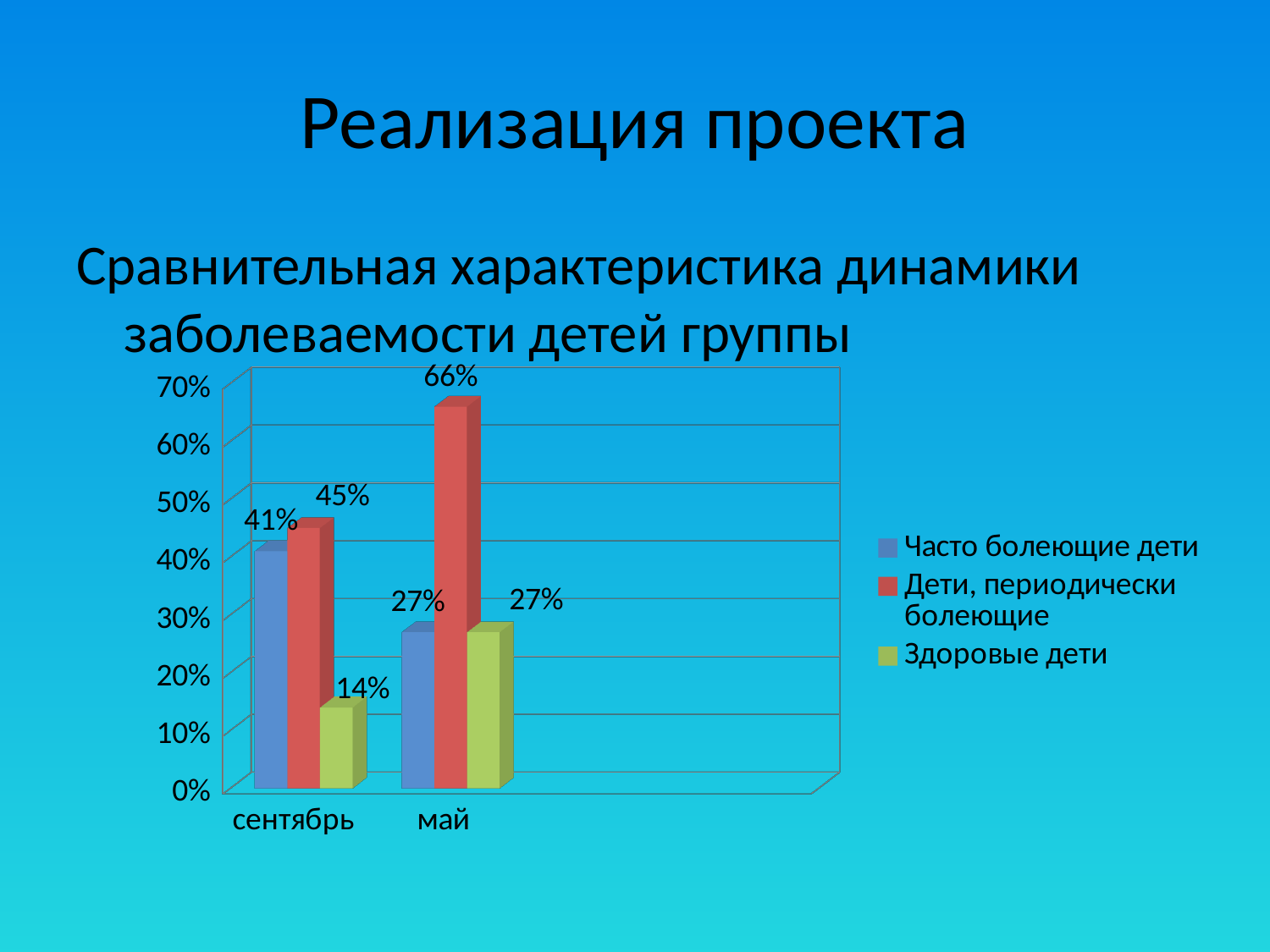
What is the value for Часто болеющие дети in май? 27% What is the value for Здоровые дети in сентябрь? 14% What type of chart is shown on the slide? bar chart Which is larger: the value for Здоровые дети in сентябрь or in май? май Which series has the highest value in май? Дети, периодически болеющие What is the value for Дети, периодически болеющие in май? 66% Does the value for Часто болеющие дети rise or fall from сентябрь to май? fall How many categories are shown on the x axis? 2 How many series does the legend list? 3 What is the difference between the value for Дети, периодически болеющие in май and in сентябрь? 21% Which series has the lowest value in сентябрь? Здоровые дети What is the value for Часто болеющие дети in сентябрь? 41%